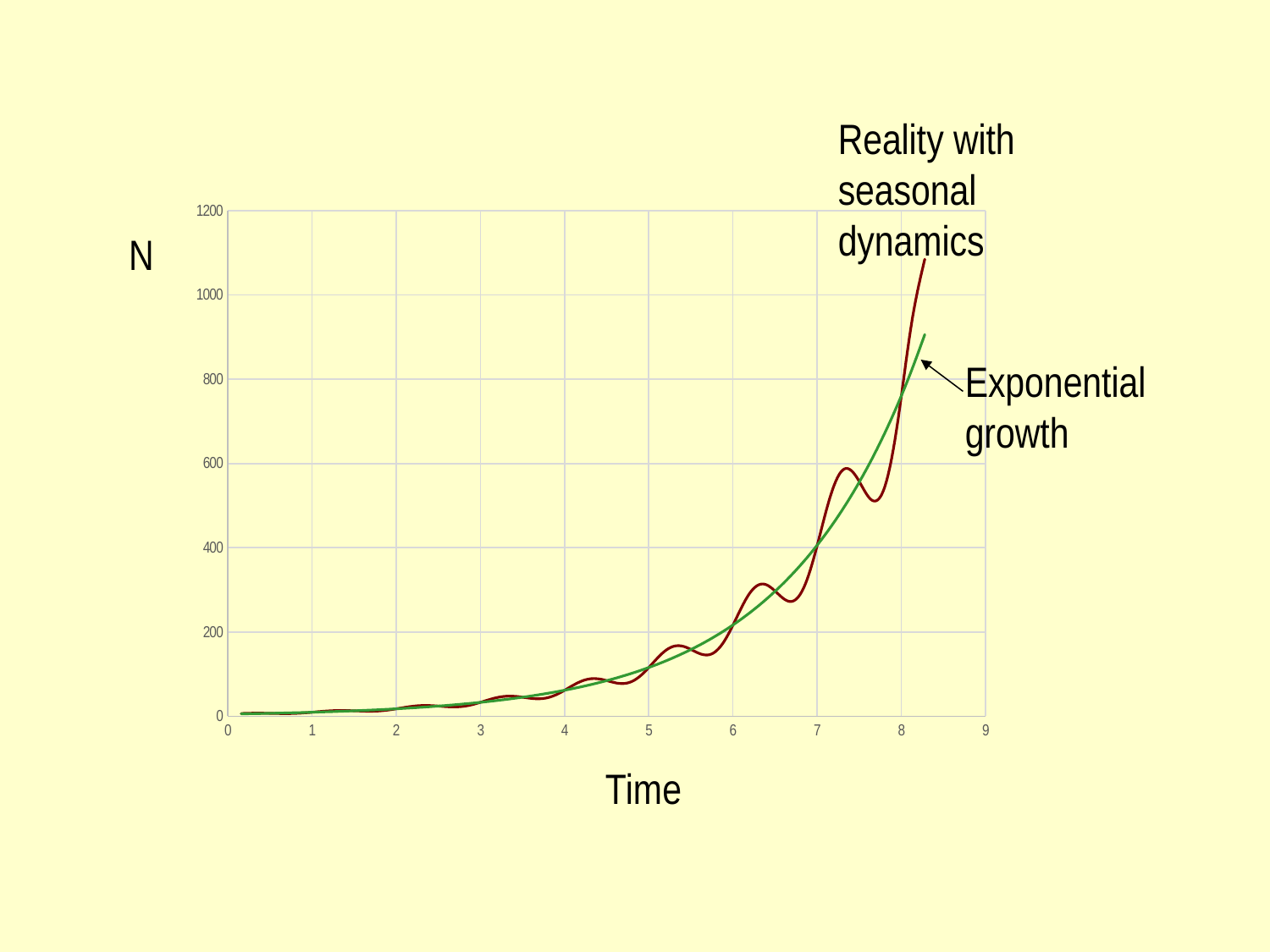
Which line shows oscillations around the other, Reality with seasonal dynamics or Exponential growth? Reality with seasonal dynamics Is the value of the Exponential growth line at Time 4 greater or less than 200? less Is the value of the Exponential growth line at Time 7 greater or less than 600? less Which line is higher at the right-hand end of the chart, Reality with seasonal dynamics or Exponential growth? Reality with seasonal dynamics Is the value of the Reality with seasonal dynamics line at Time 8 greater or less than 600? greater What kind of chart is shown on the slide? line chart What is the label of the vertical axis? N Do the values of the Exponential growth line rise or fall as Time increases? rise What is the label of the horizontal axis? Time How many lines (series) are plotted on the chart? 2